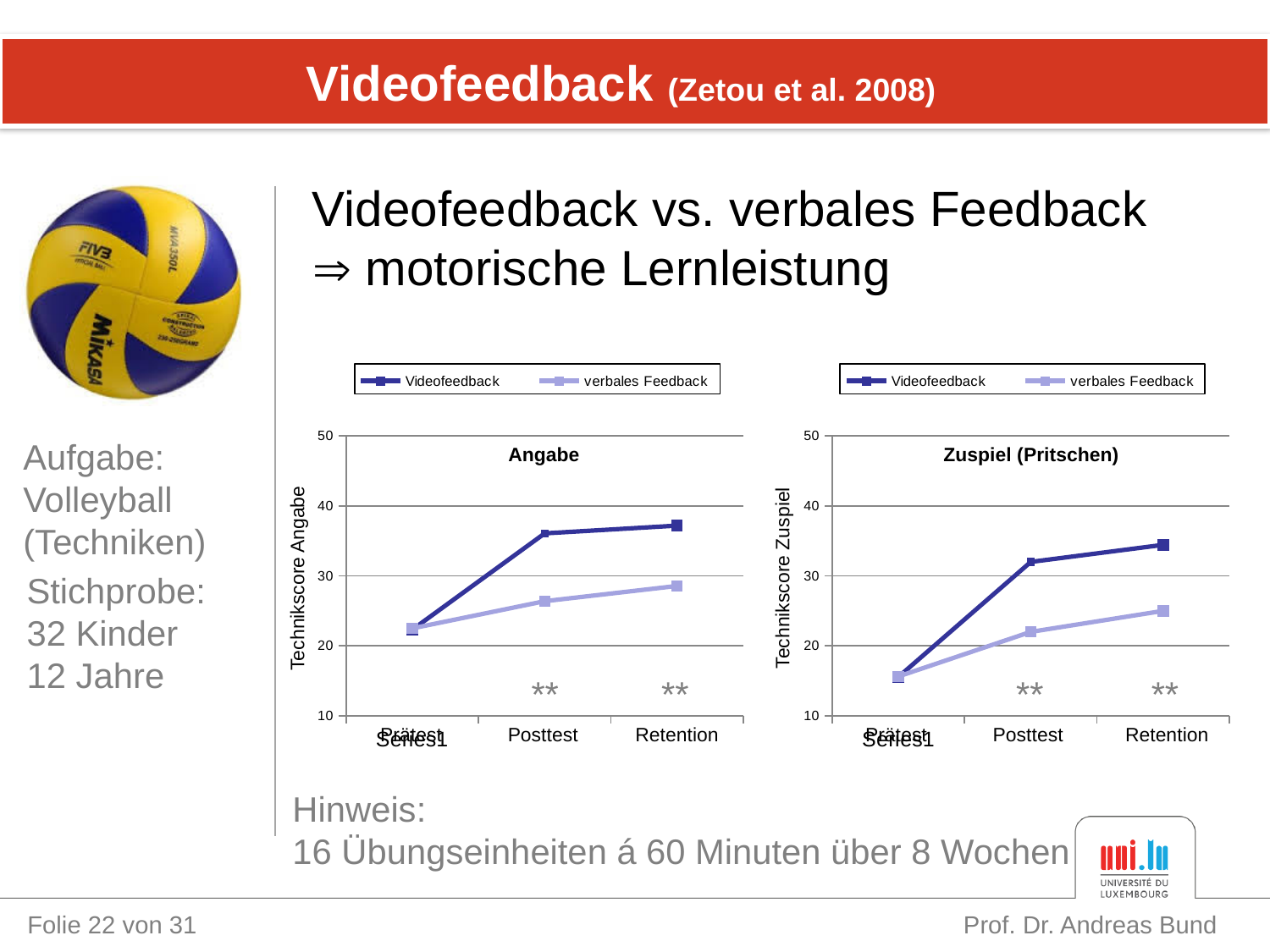
In the 'Angabe' chart, which series has the higher value at Retention, Videofeedback or verbales Feedback? Videofeedback In the 'Zuspiel (Pritschen)' chart, which series has the higher value at Posttest, Videofeedback or verbales Feedback? Videofeedback In the 'Zuspiel (Pritschen)' chart, is the Videofeedback value at Retention greater or less than 30? greater In the 'Angabe' chart, is the Videofeedback value at Posttest greater or less than 30? greater What kind of chart is the 'Angabe' chart on the left? line chart In the 'Angabe' chart, is the verbales Feedback value at Retention greater or less than 30? less What is the y-axis label of the 'Zuspiel (Pritschen)' chart? Technikscore Zuspiel In the 'Angabe' chart, does the Videofeedback line rise or fall from Prätest to Retention? rise How many series does the legend of the 'Zuspiel (Pritschen)' chart list? 2 How many test time points are shown on the x axis of the 'Angabe' chart? 3